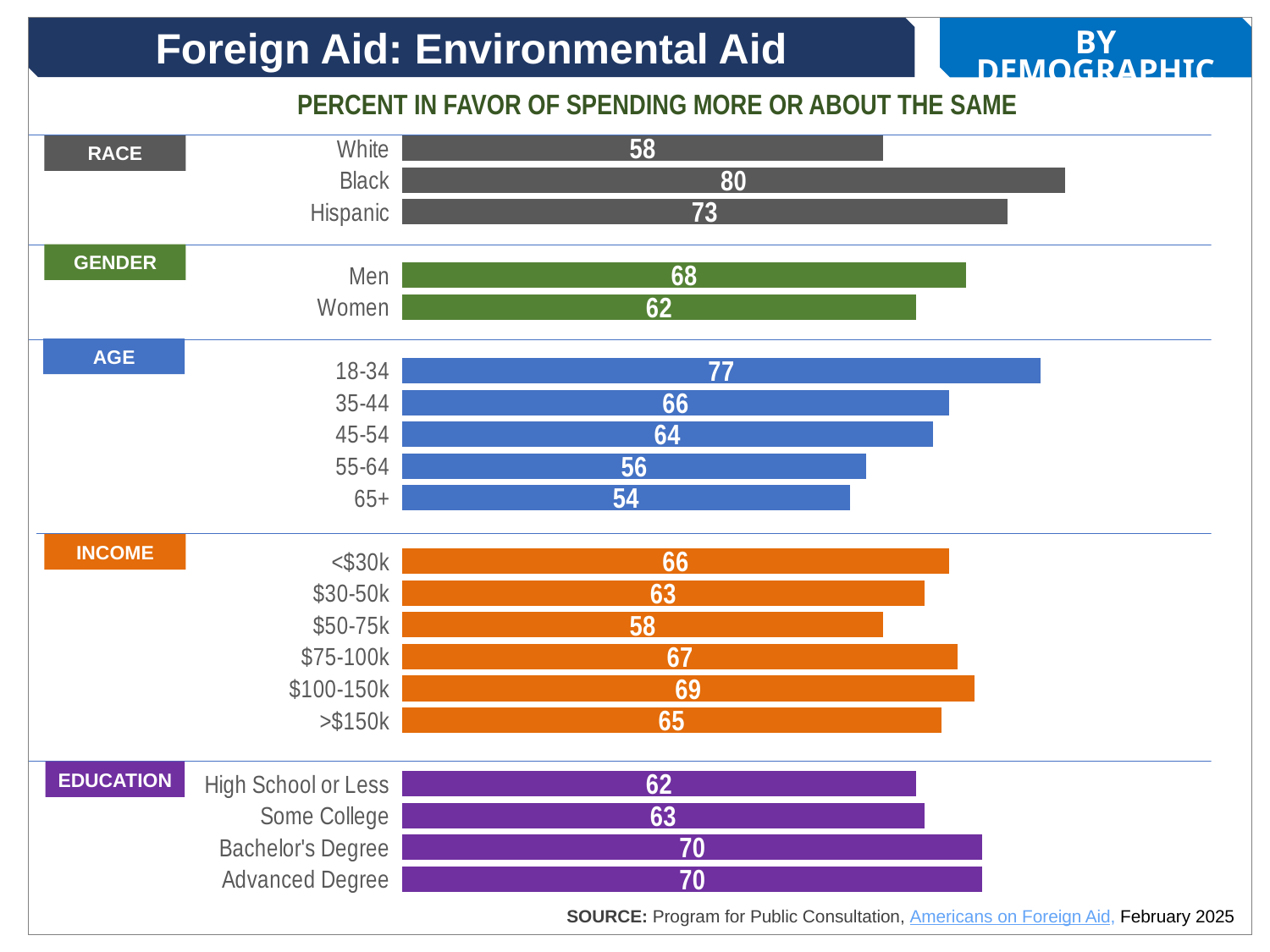
What is the value for Women in the Gender section? 62 What is the value for Black in the Race section? 80 Which age group has the highest value? 18-34 What is the difference between the values for Black and White? 22 Which is larger, the value for Men or the value for Women? Men What is the value for the $100-150k income group? 69 What kind of chart is shown on the slide? Bar chart What is the value for the 65+ age group? 54 How many age groups are shown on the chart? 5 How many education categories are shown on the chart? 4 Which income group has the lowest value? $50-75k Do the values rise or fall as the age groups go from 18-34 to 65+? Fall